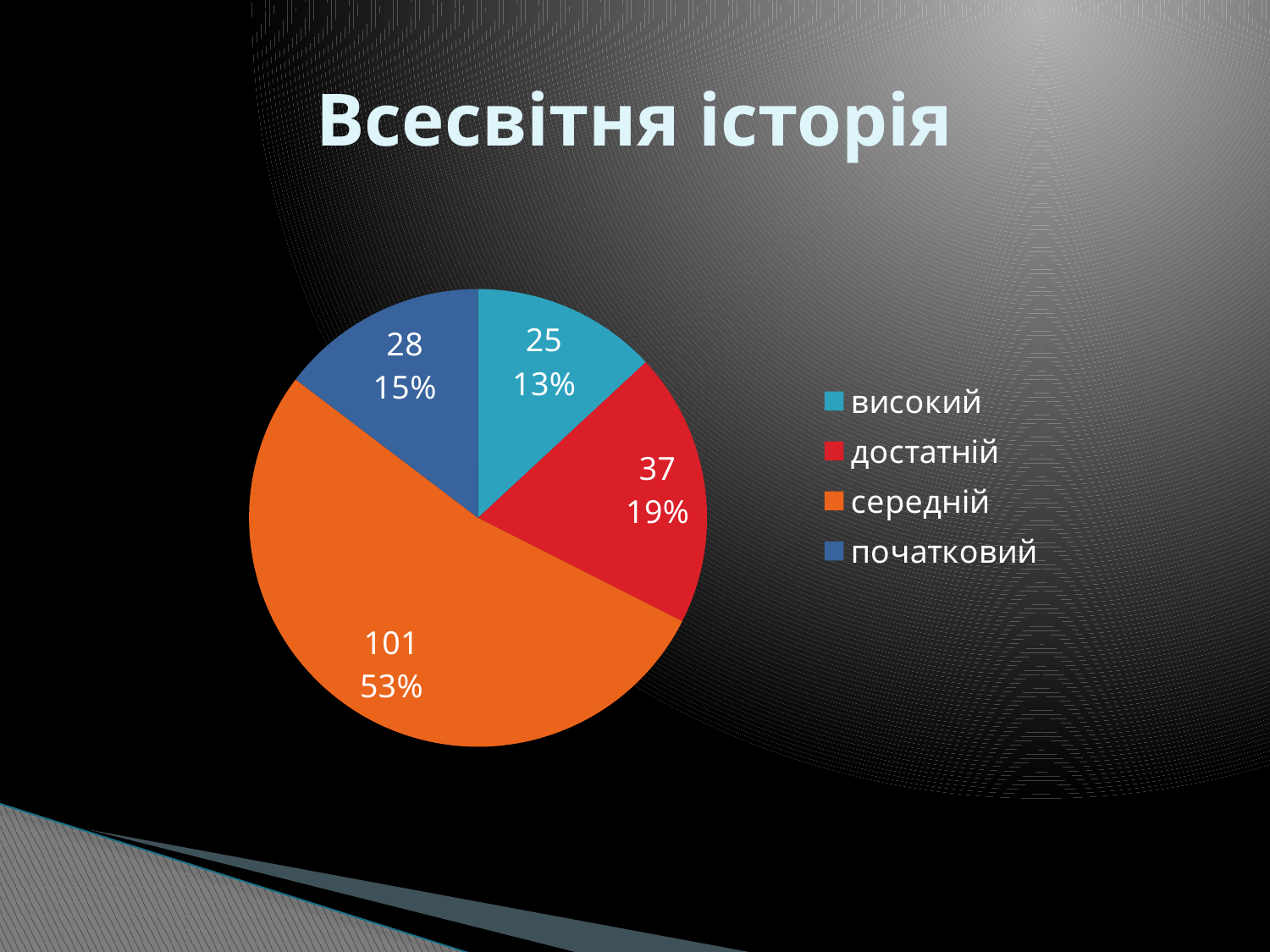
What percentage share does початковий have? 15% What kind of chart is shown on the slide? pie chart What is the value for середній? 101 Which category has the largest slice? середній What is the title of the chart? Всесвітня історія What is the value for високий? 25 How many slices does the pie chart have? 4 What percentage share does достатній have? 19% Which is larger, the value for початковий or the value for достатній? достатній What colour is the slice for початковий? blue What is the difference between the values for середній and достатній? 64 Which category has the smallest slice? високий